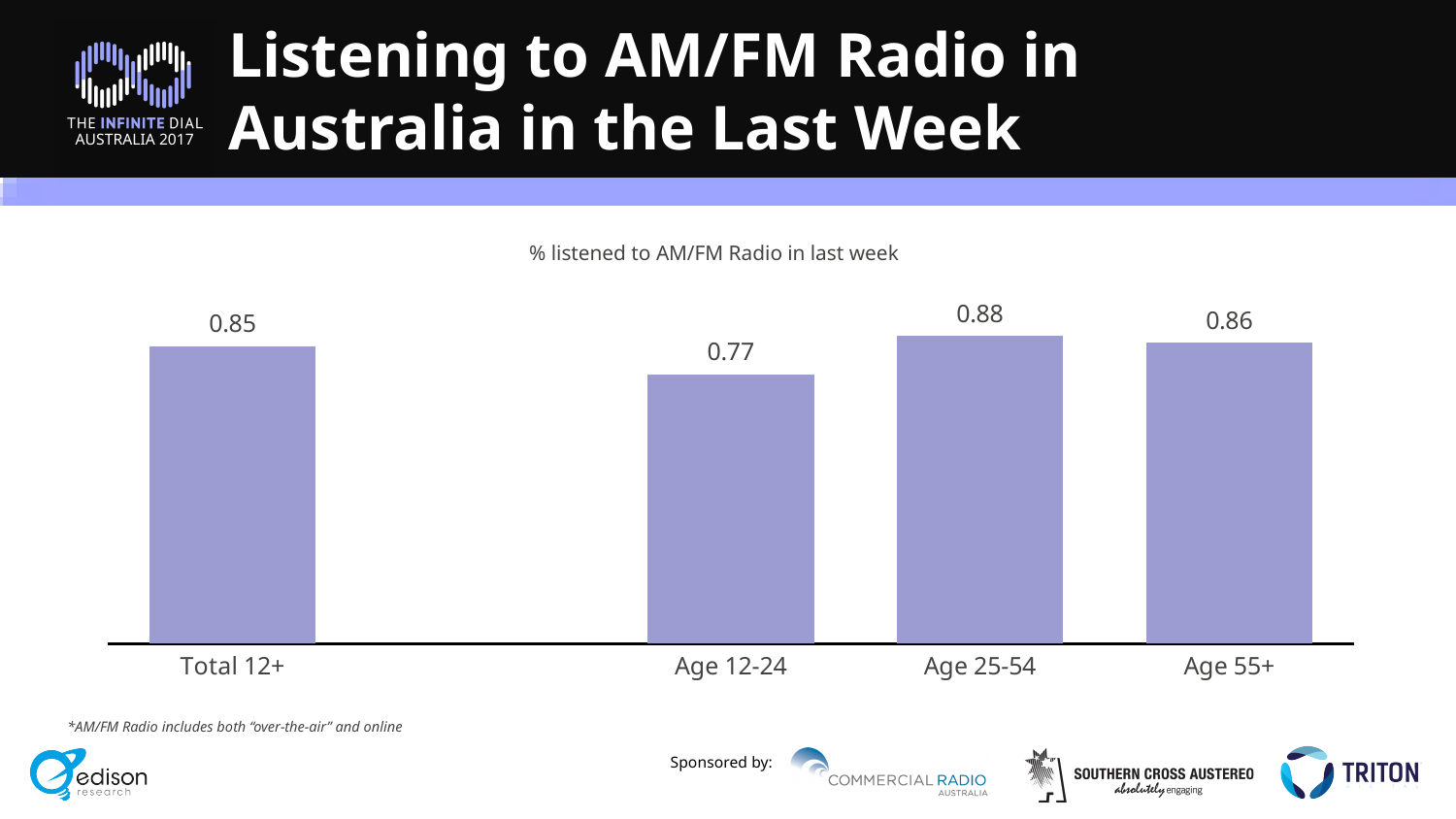
What kind of chart is shown on the slide? Bar chart What is the value for Age 25-54? 0.88 What is the difference between the values for Age 25-54 and Age 12-24? 0.11 What is the chart's title? % listened to AM/FM Radio in last week What is the value for Age 55+? 0.86 What is the value for Age 12-24? 0.77 What is the difference between the values for Age 55+ and Total 12+? 0.01 Which category has the highest value? Age 25-54 Which category has the lowest value? Age 12-24 How many categories are shown on the chart? 4 What is the value for Total 12+? 0.85 Which is larger, the value for Total 12+ or the value for Age 12-24? Total 12+